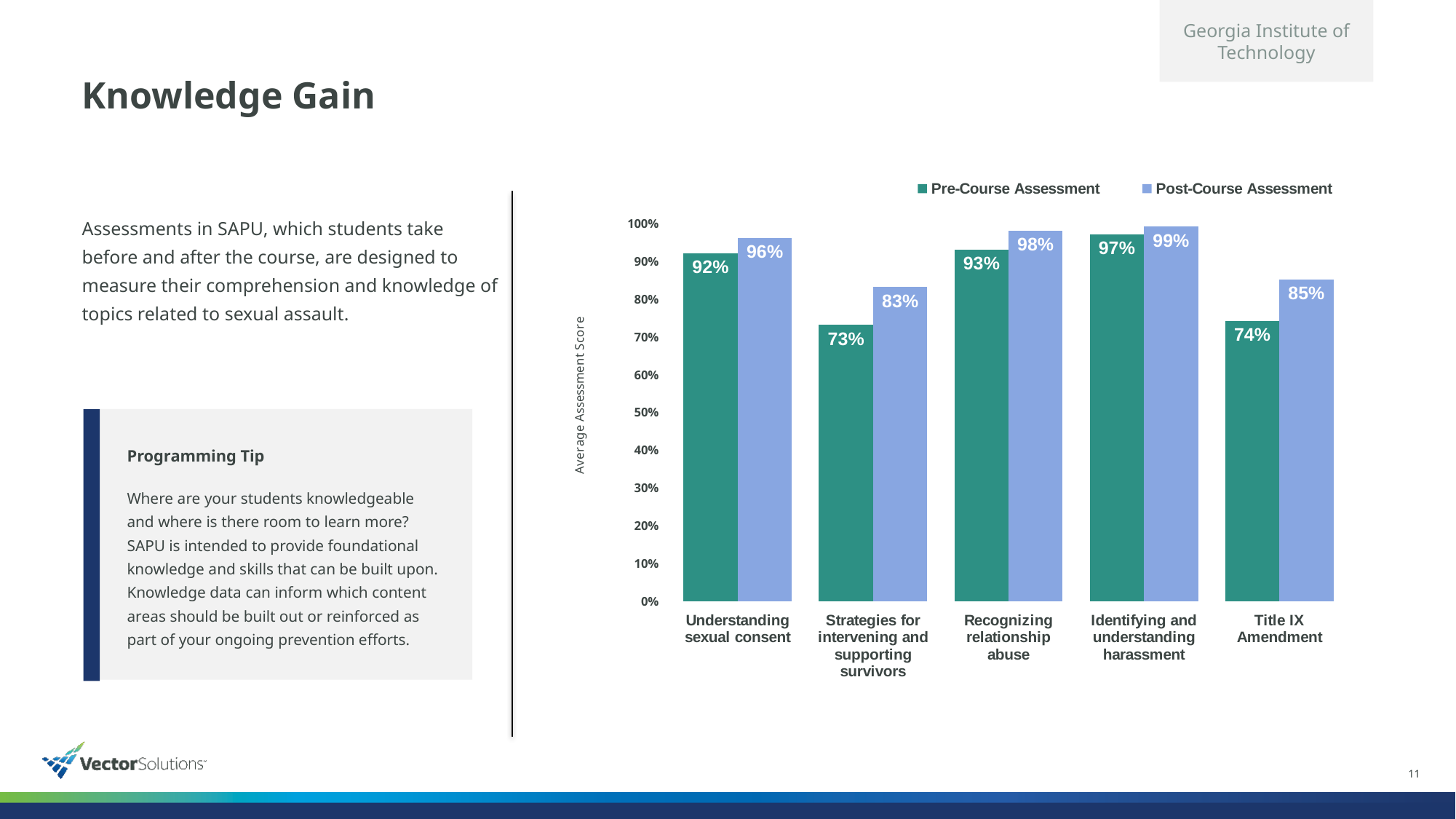
Which is larger: the Pre-Course Assessment value for Recognizing relationship abuse or the Pre-Course Assessment value for Title IX Amendment? Recognizing relationship abuse Which colour represents the Post-Course Assessment series? Blue What is the Pre-Course Assessment value for Understanding sexual consent? 92% How many series does the legend list? 2 What is the label of the vertical axis? Average Assessment Score What is the Post-Course Assessment value for Strategies for intervening and supporting survivors? 83% How many categories are shown on the x axis? 5 What is the difference between the Post-Course and Pre-Course Assessment values for Title IX Amendment? 11% What kind of chart is shown on the slide? Bar chart What is the Post-Course Assessment value for Title IX Amendment? 85% Which category has the highest Post-Course Assessment value? Identifying and understanding harassment Which category has the lowest Pre-Course Assessment value? Strategies for intervening and supporting survivors